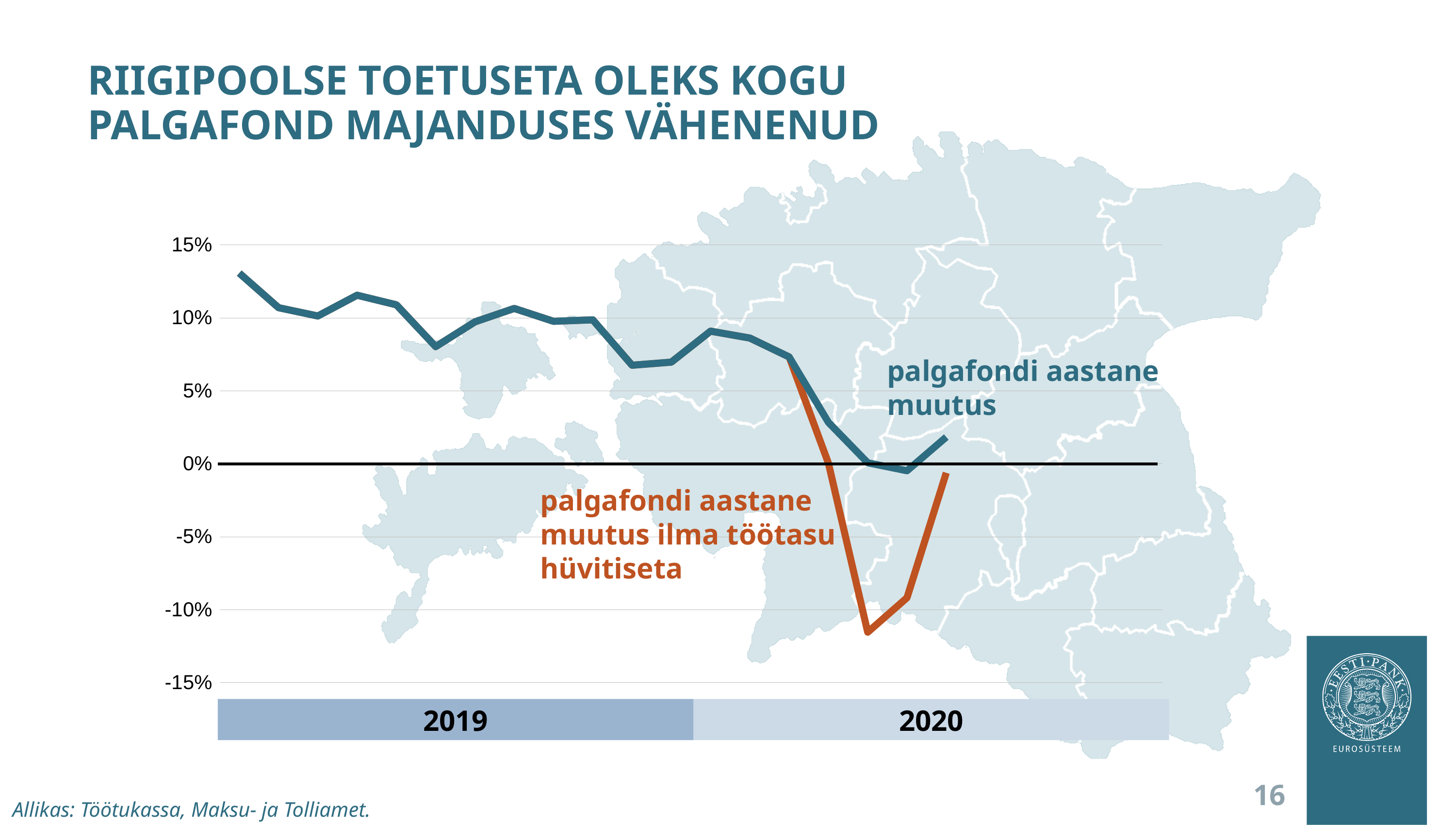
Is the lowest point of the 'palgafondi aastane muutus ilma töötasu hüvitiseta' line greater or less than -10%? less What colour is the 'palgafondi aastane muutus ilma töötasu hüvitiseta' line? orange What is the highest value shown on the chart's vertical axis? 15% Is the lowest point of the 'palgafondi aastane muutus' line greater or less than -5%? greater How many data series are plotted on the chart? 2 Which series has the higher value at its lowest point, 'palgafondi aastane muutus' or 'palgafondi aastane muutus ilma töötasu hüvitiseta'? palgafondi aastane muutus Which series reaches the lowest value on the chart? palgafondi aastane muutus ilma töötasu hüvitiseta Is the first plotted value of the 'palgafondi aastane muutus' line in 2019 greater or less than 10%? greater Does the 'palgafondi aastane muutus' line generally rise or fall over the course of 2019? fall Which two years are shown on the x axis of the chart? 2019 and 2020 What kind of chart is shown on the slide? line chart